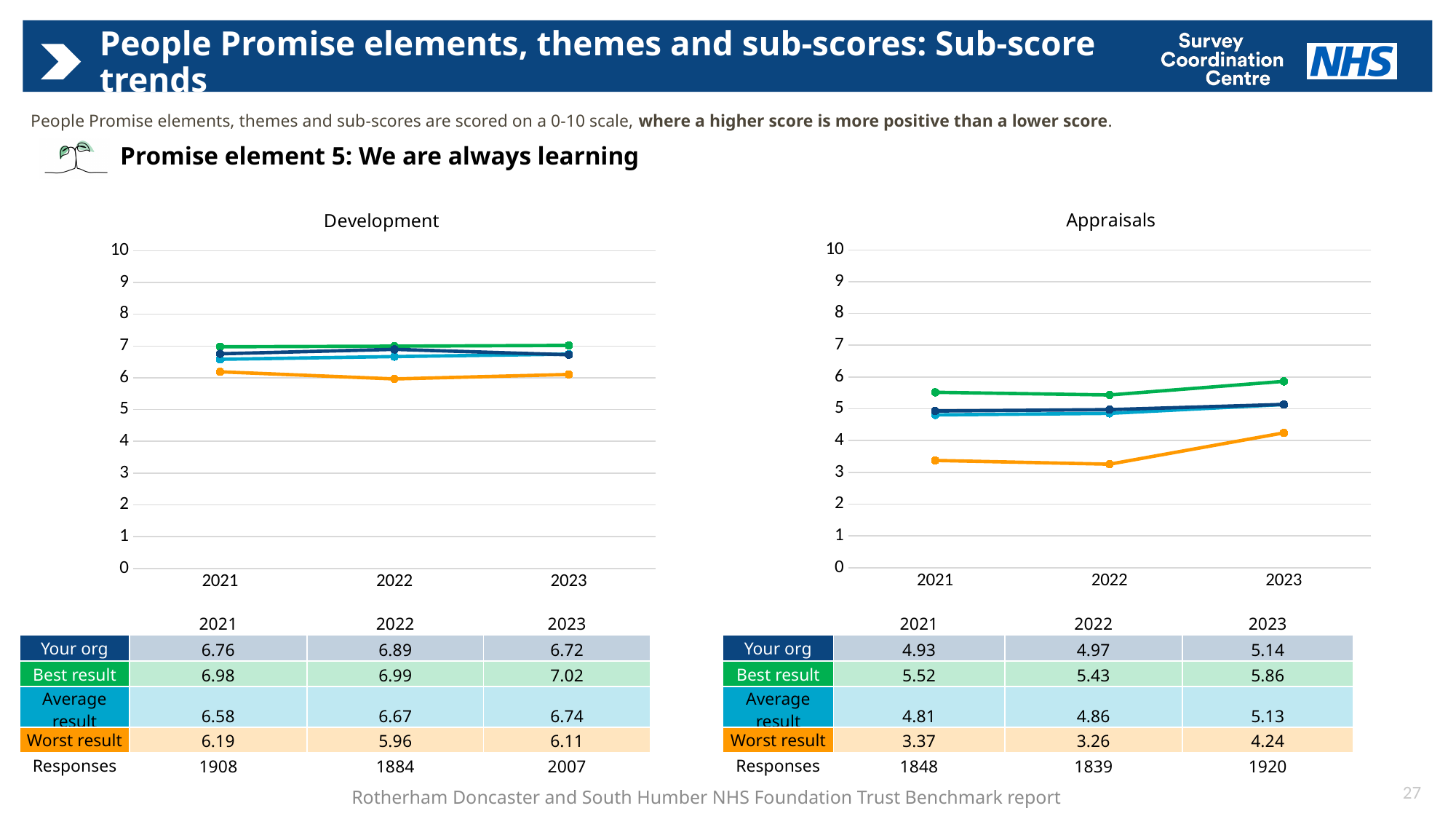
In the Appraisals chart, what is the Best result value in 2021? 5.52 In the Appraisals chart, what is the difference between Your org and Average result in 2021? 0.12 In the Development chart, what is the difference between the Best result and Worst result in 2022? 1.03 In the Development chart, what is the value for Your org in 2022? 6.89 In the Appraisals chart, which year has the lowest Worst result value? 2022 What kind of chart is the Development chart? Line chart In the Development chart, is the Worst result value for 2022 greater or less than 6? less In the Development chart, which year has the highest Best result value? 2023 In the Appraisals chart, which is larger in 2023: Your org or Average result? Your org How many years are plotted on the x axis of the Appraisals chart? 3 In the Appraisals chart, what is the Worst result value in 2023? 4.24 In the Appraisals chart, does the Your org line rise or fall from 2021 to 2023? Rise